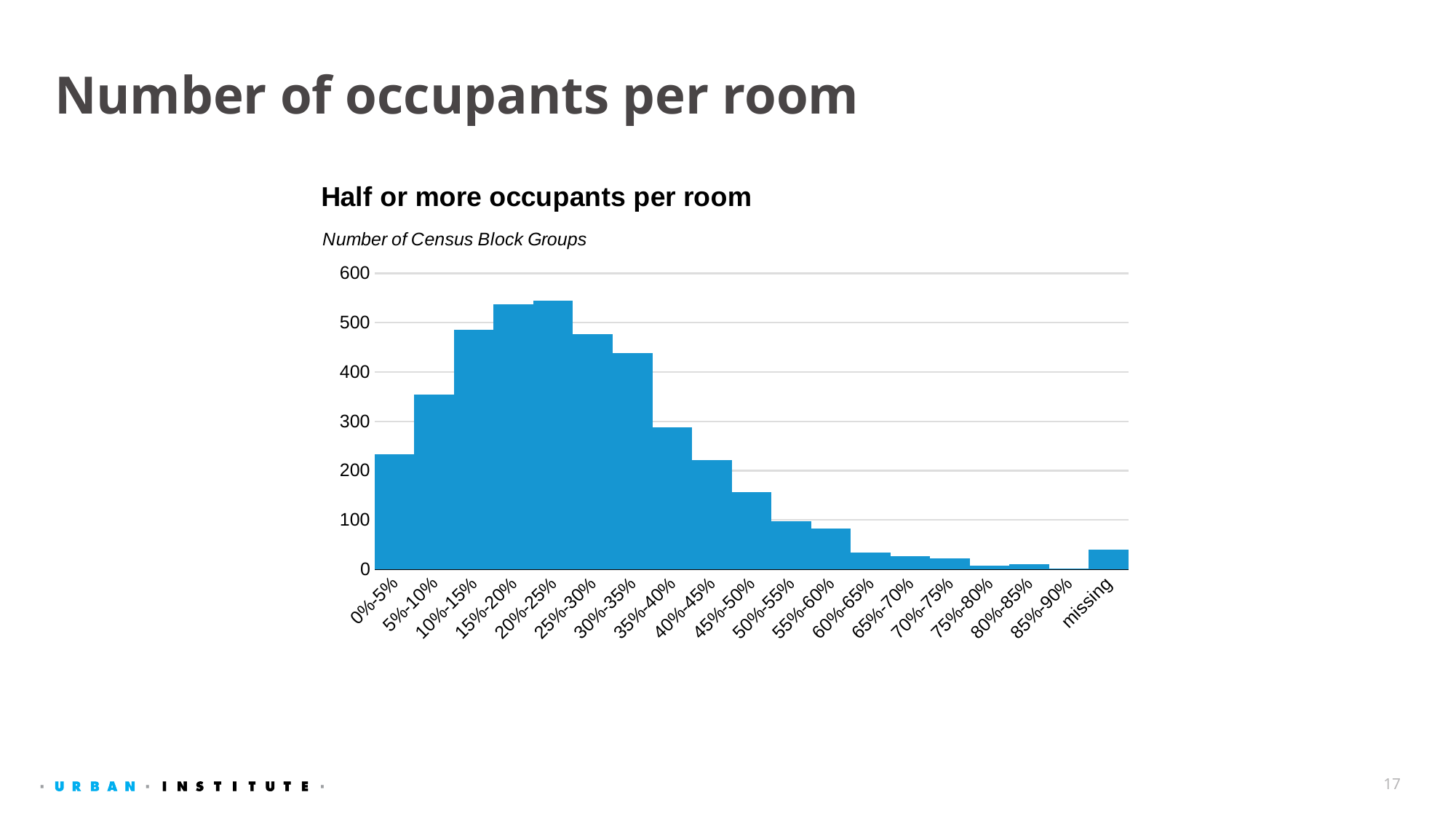
Is the value for 55%-60% greater or less than 100? less What kind of chart is shown on the slide? bar chart Which category has the lowest number of census block groups? 85%-90% Which is larger, the value for 5%-10% or the value for 30%-35%? 30%-35% Is the value for 25%-30% greater or less than 500? less Is the value for missing greater or less than 100? less How many categories are shown on the x axis of the chart? 19 Do the values rise or fall along the x axis from 20%-25% to 85%-90%? fall What is the title of the chart? Half or more occupants per room